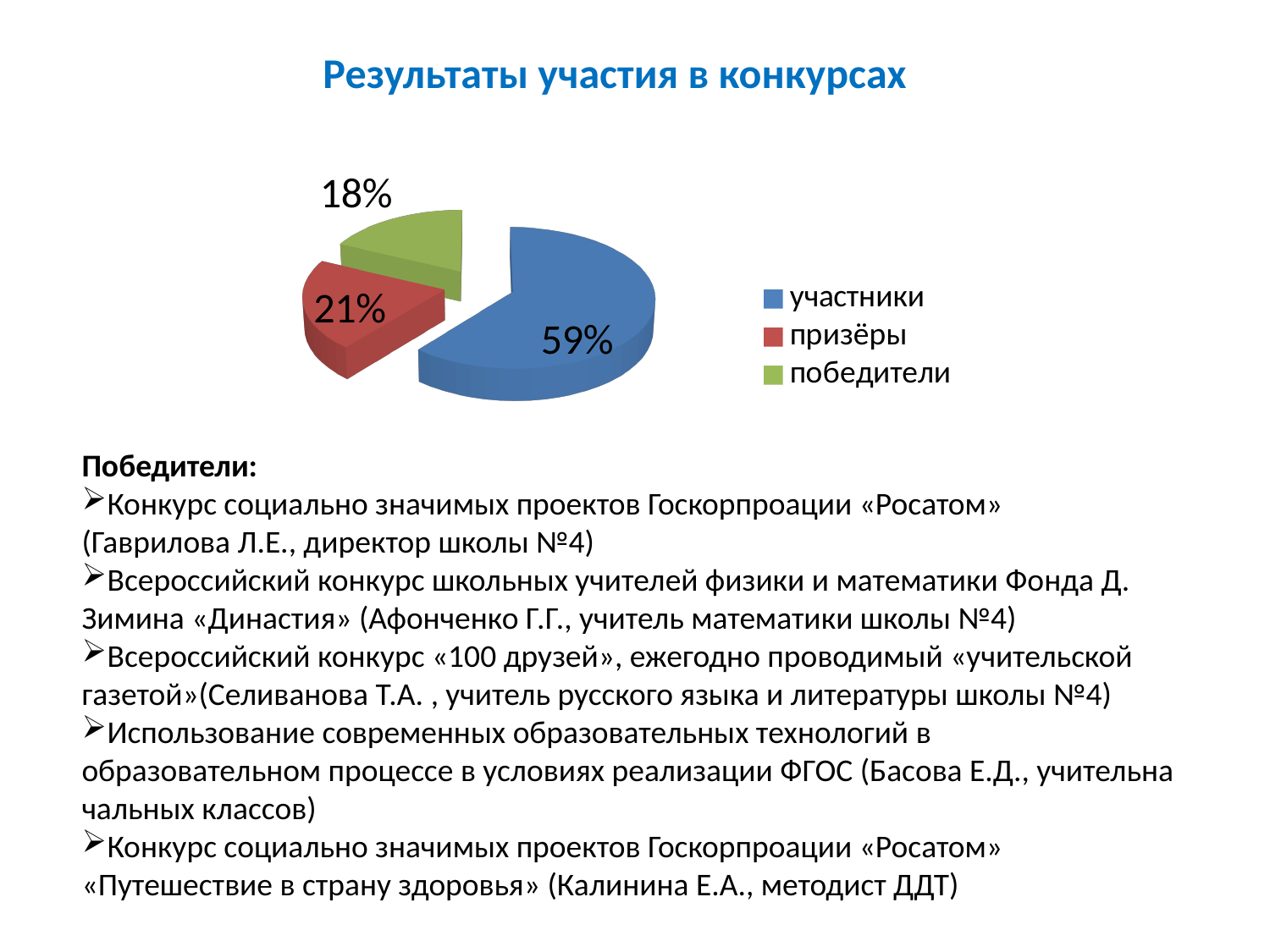
What is the difference in percentage points between участники and призёры? 38 Which is larger, the share for участники or the share for победители? участники Which category has the smallest slice of the pie? победители What is the difference in percentage points between призёры and победители? 3 What kind of chart is shown on the slide? pie chart Which category has the largest slice of the pie? участники What share of the pie does призёры take? 21% What share of the pie does участники take? 59% What share of the pie does победители take? 18% How many slices does the pie chart have? 3 What colour is the slice for призёры? red How many entries does the legend list? 3